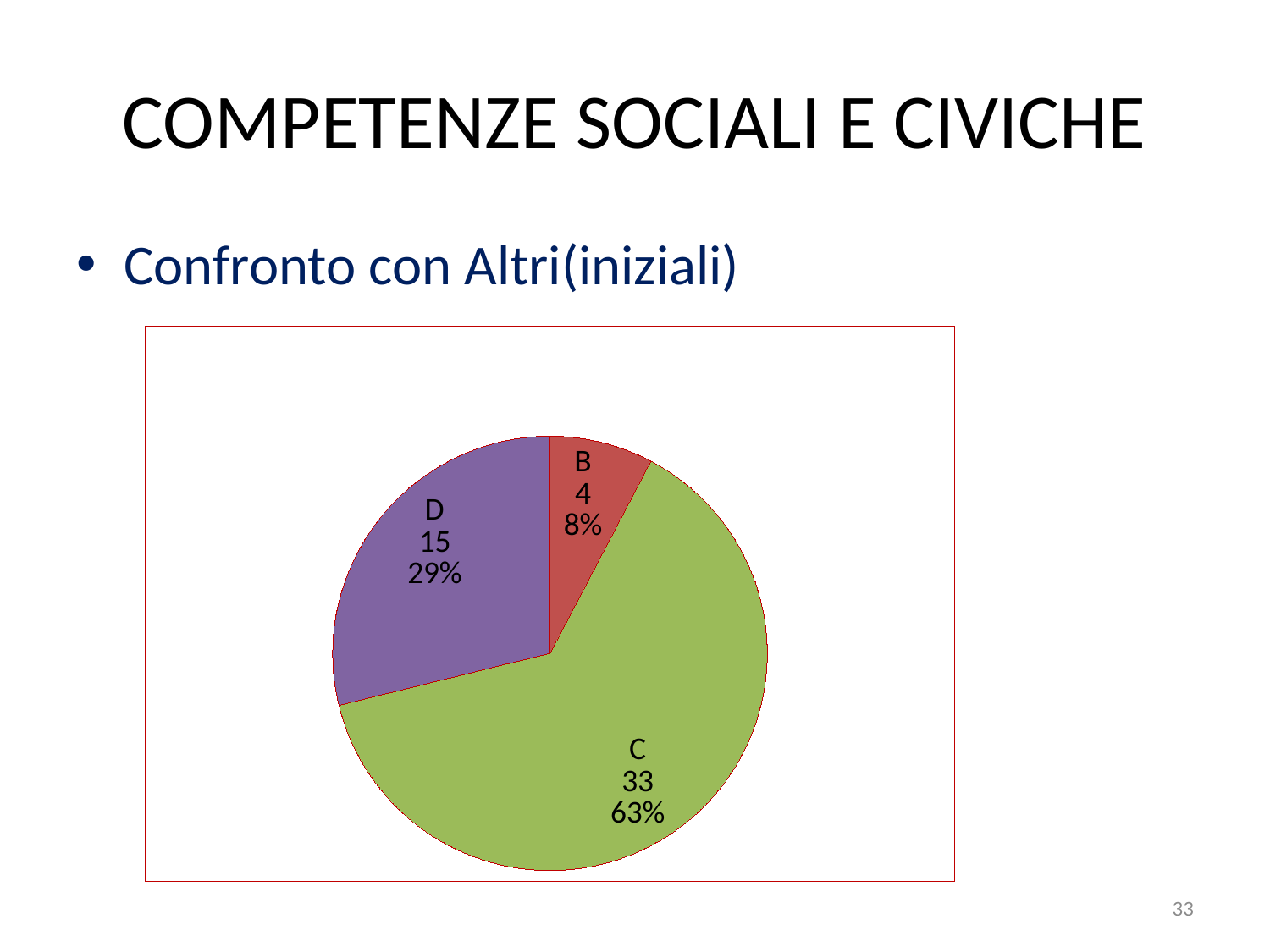
What is the value for category D? 15 What is the value for category B? 4 What is the value for category C? 33 Which category has the largest slice? C Which is larger, the value for D or the value for B? D What is the difference between the values for C and D? 18 Which category has the smallest slice? B What share of the pie does slice B represent? 8% What kind of chart is shown on the slide? pie chart How many slices does the pie chart have? 3 What share of the pie does slice C represent? 63% What share of the pie does slice D represent? 29%